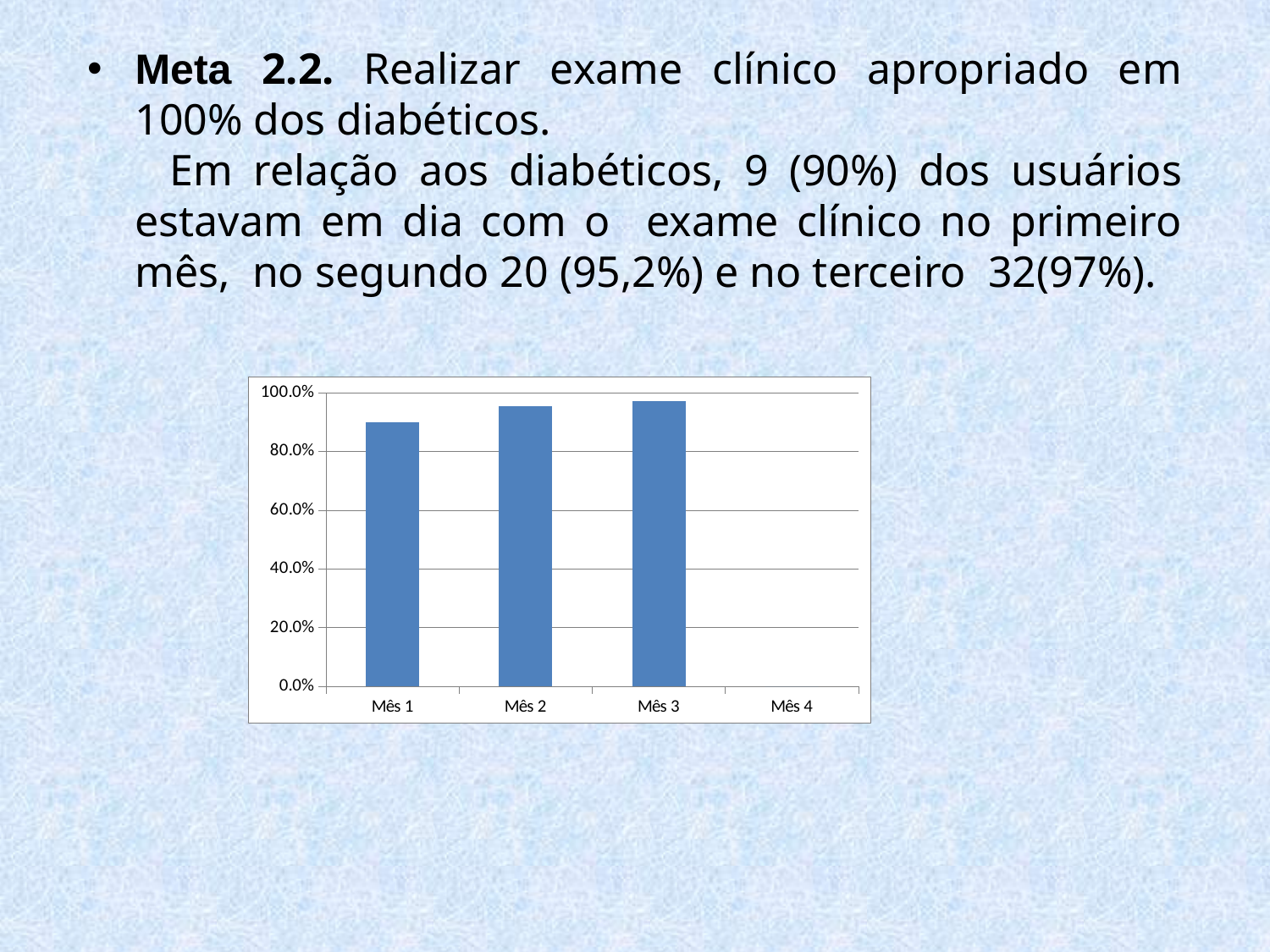
What kind of chart is shown on the slide? bar chart Is the value for Mês 3 greater or less than 100%? less Is the value for Mês 2 greater or less than 80%? greater How many categories are shown on the x axis of the chart? 4 Is the value for Mês 1 greater or less than 100%? less Which has the larger value, Mês 1 or Mês 3? Mês 3 Which has the larger value, Mês 1 or Mês 2? Mês 2 Do the bar values rise or fall from Mês 1 to Mês 3? rise What is the highest value shown on the y axis of the chart? 100.0% Which category on the x axis has no bar plotted? Mês 4